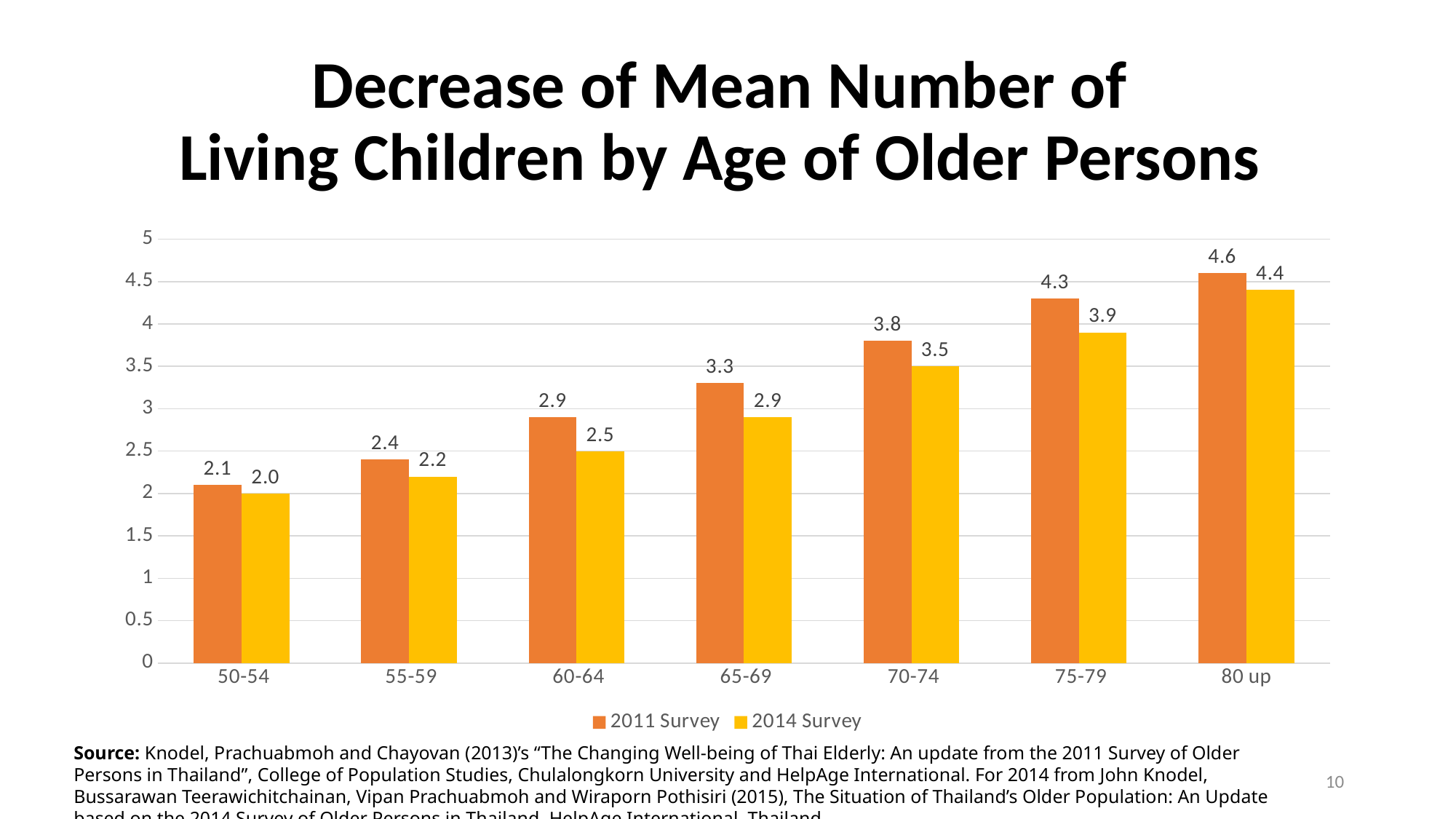
For the 70-74 age group, which survey shows the larger value, 2011 or 2014? 2011 Survey How many age groups are shown on the x axis? 7 What is the mean number of living children for the 75-79 age group in the 2014 Survey? 3.9 What is the mean number of living children for the 60-64 age group in the 2011 Survey? 2.9 What colour are the bars for the 2014 Survey? Yellow Which age group has the lowest value in the 2011 Survey? 50-54 Is the 2014 Survey value for the 80 up age group greater or less than 4? greater Do the 2011 Survey values rise or fall as age group increases along the x axis? Rise Which age group has the highest value in the 2014 Survey? 80 up How many series does the legend list? 2 What is the difference between the 2011 Survey and 2014 Survey values for the 65-69 age group? 0.4 What kind of chart is shown on the slide? Bar chart